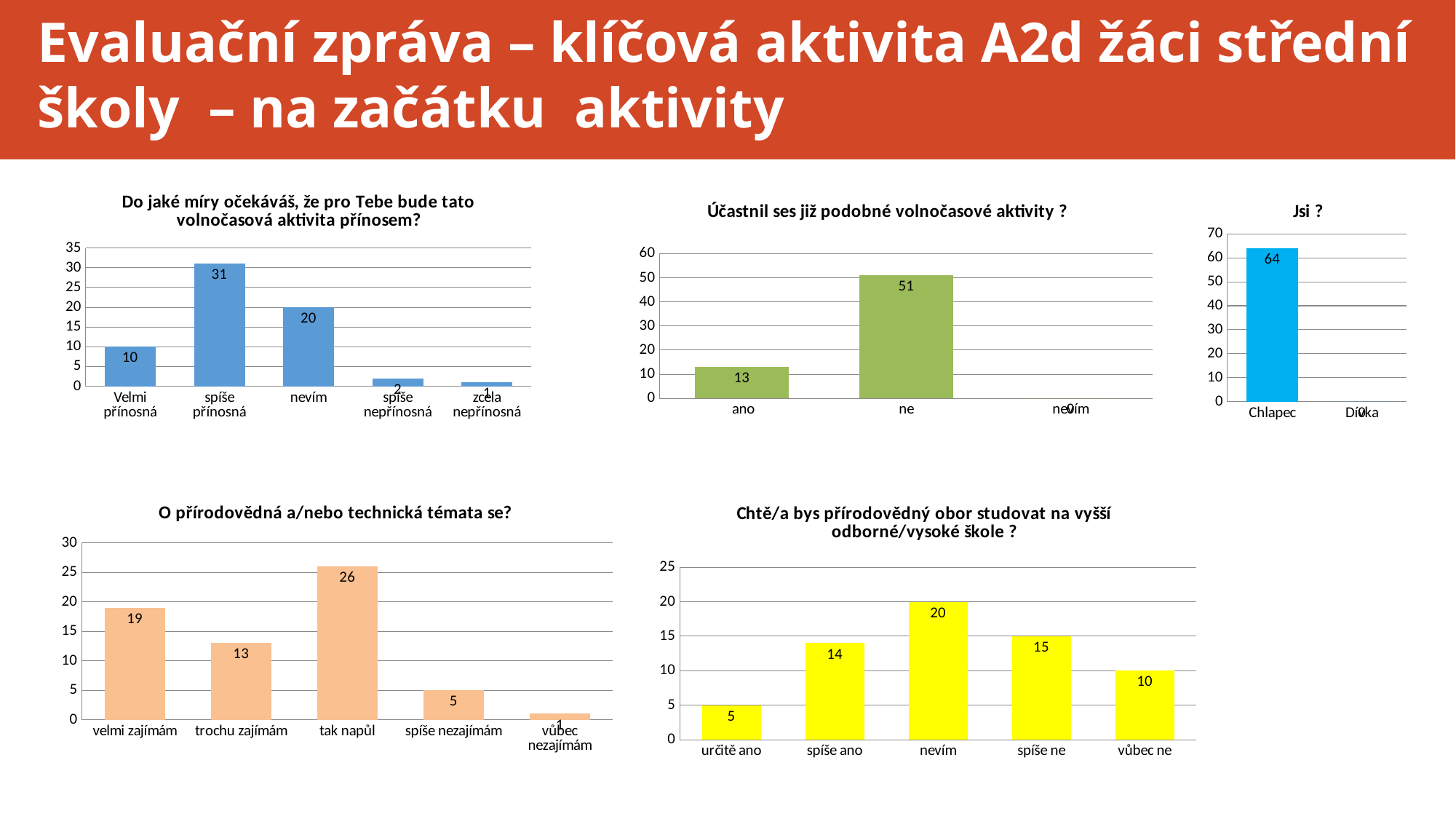
In the chart 'Účastnil ses již podobné volnočasové aktivity ?', what is the difference between 'ne' and 'ano'? 38 In the chart 'Chtě/a bys přírodovědný obor studovat na vyšší odborné/vysoké škole ?', which category has the lowest value? určitě ano What kind of chart is 'Chtě/a bys přírodovědný obor studovat na vyšší odborné/vysoké škole ?'? bar chart In the chart 'Do jaké míry očekáváš, že pro Tebe bude tato volnočasová aktivita přínosem?', what is the value for 'spíše přínosná'? 31 In the chart 'O přírodovědná a/nebo technická témata se?', which category has the highest value? tak napůl In the chart 'Jsi ?', what is the value for 'Chlapec'? 64 In the chart 'O přírodovědná a/nebo technická témata se?', which is larger, 'trochu zajímám' or 'spíše nezajímám'? trochu zajímám In the chart 'Do jaké míry očekáváš, že pro Tebe bude tato volnočasová aktivita přínosem?', which category has the highest value? spíše přínosná In the chart 'O přírodovědná a/nebo technická témata se?', what is the value for 'velmi zajímám'? 19 In the chart 'Jsi ?', how many categories are shown on the x axis? 2 In the chart 'Chtě/a bys přírodovědný obor studovat na vyšší odborné/vysoké škole ?', what is the value for 'nevím'? 20 In the chart 'Účastnil ses již podobné volnočasové aktivity ?', what is the value for 'ne'? 51